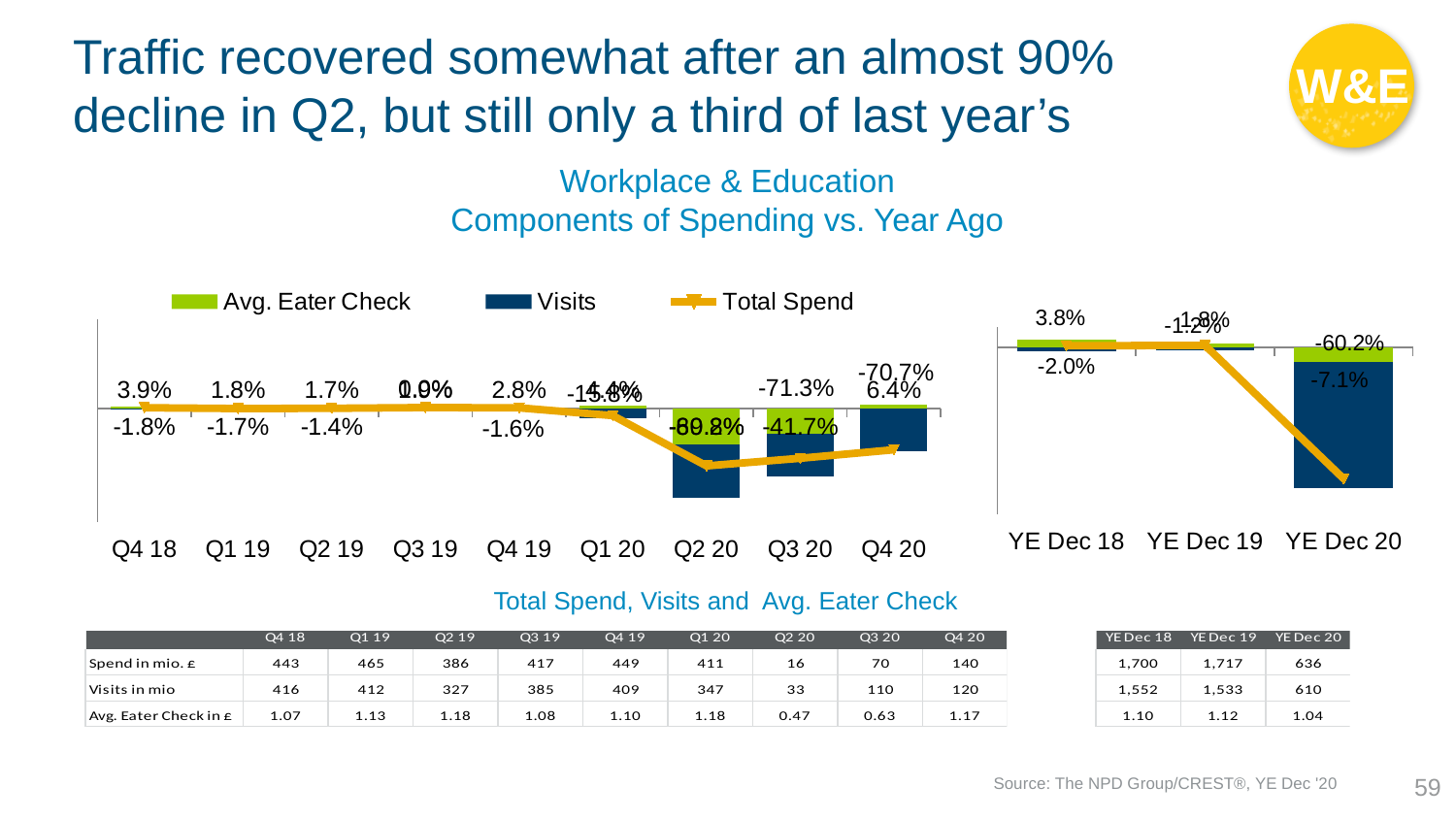
What kind of chart is the quarterly chart on the left? Combination bar and line chart How many series does the legend of the quarterly chart list? 3 In the year-end chart on the right, what is the Avg. Eater Check value for YE Dec 18? 3.8% In the quarterly chart on the left, what is the Visits value for Q4 18? -1.8% In the quarterly chart on the left, what is the Avg. Eater Check value for Q4 18? 3.9% How many quarters are shown on the x axis of the quarterly chart on the left? 9 In the quarterly chart on the left, what is the Visits value for Q3 20? -71.3% In the quarterly chart on the left, which quarter has the lowest Visits value? Q2 20 In the quarterly chart on the left, what is the Avg. Eater Check value for Q4 20? 6.4% In the quarterly chart on the left, what is the Avg. Eater Check value for Q4 19? 2.8% In the year-end chart on the right, what is the Visits value for YE Dec 20? -60.2% In the year-end chart on the right, what is the Avg. Eater Check value for YE Dec 20? -7.1%